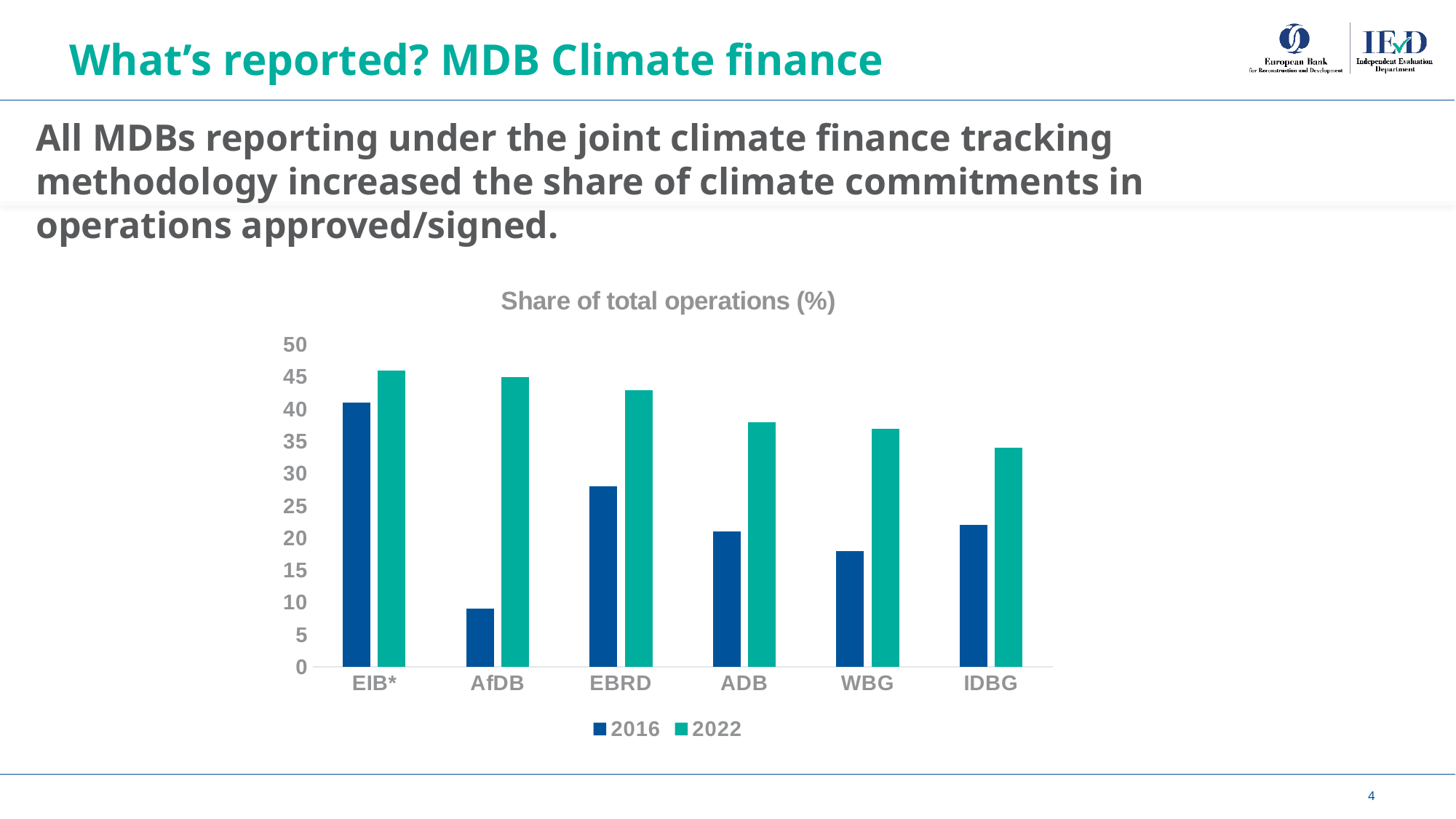
Which is larger: the 2016 value for EBRD or the 2016 value for ADB? EBRD Which MDB has the lowest 2016 share of total operations? AfDB Is the 2016 value for AfDB greater or less than 10? less Which MDB has the highest 2016 share of total operations? EIB* Which MDB has the lowest 2022 share of total operations? IDBG How many MDBs (categories) are shown on the x axis of the chart? 6 What type of chart is shown on the slide? bar chart Is the 2016 value for EIB* greater or less than 40? greater What is the title of the chart? Share of total operations (%) Which is larger: the 2022 value for WBG or the 2022 value for IDBG? WBG How many series does the chart legend list? 2 Is the 2022 value for ADB greater or less than 35? greater